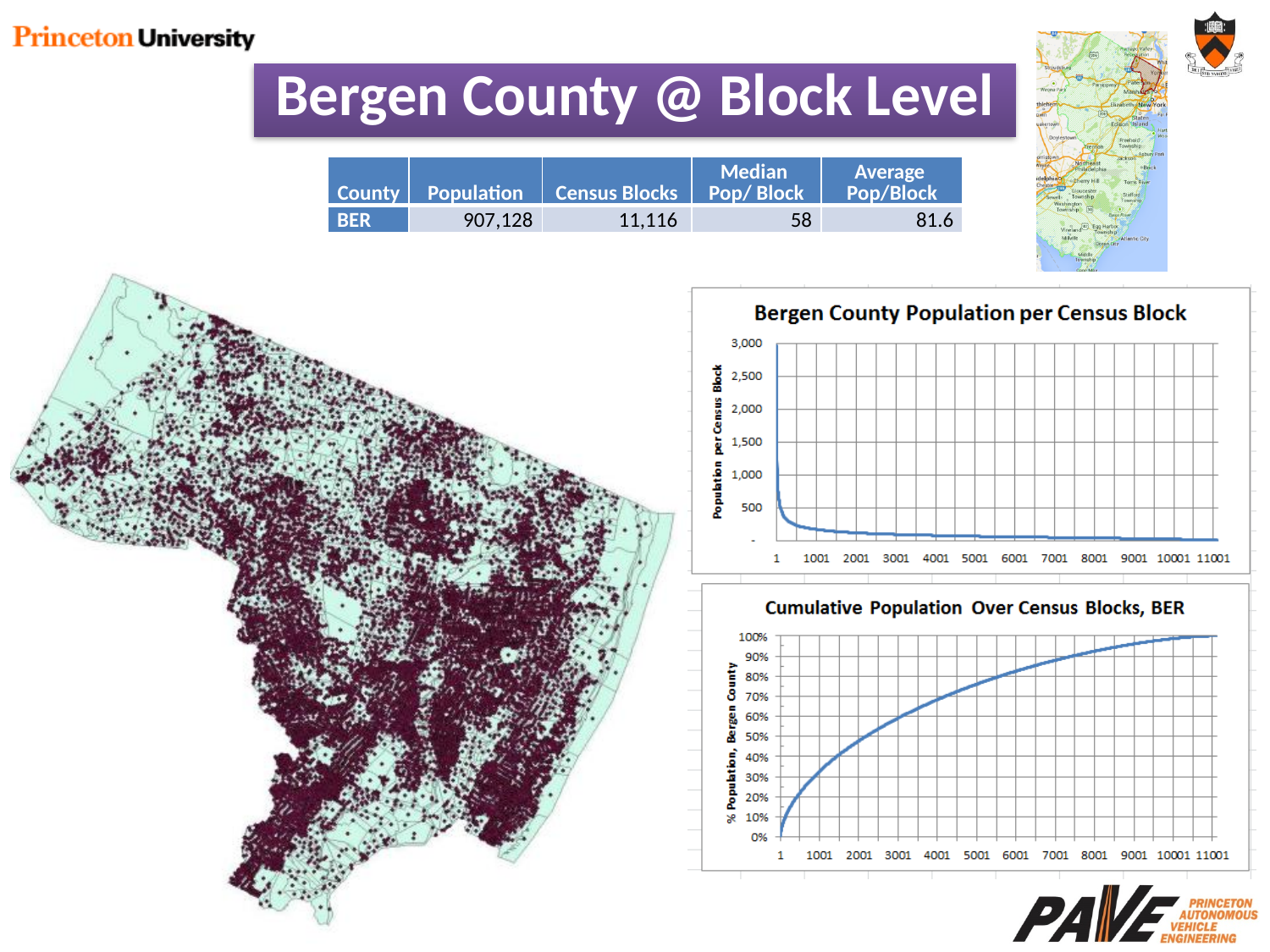
What is the y-axis title of the 'Cumulative Population Over Census Blocks, BER' chart? % Population, Bergen County In the 'Cumulative Population Over Census Blocks, BER' chart, is the value at census block 3001 greater or less than 40%? greater In the 'Cumulative Population Over Census Blocks, BER' chart, is the value at census block 9001 greater or less than 80%? greater What kind of chart is the 'Cumulative Population Over Census Blocks, BER' chart? line chart In the 'Cumulative Population Over Census Blocks, BER' chart, do the values rise or fall as you move along the x axis? rise In the 'Bergen County Population per Census Block' chart, do the values rise or fall as you move along the x axis? fall What kind of chart is the 'Bergen County Population per Census Block' chart? line chart In the 'Cumulative Population Over Census Blocks, BER' chart, is the value at census block 1001 greater or less than 10%? greater What is the highest tick label on the y axis of the 'Bergen County Population per Census Block' chart? 3,000